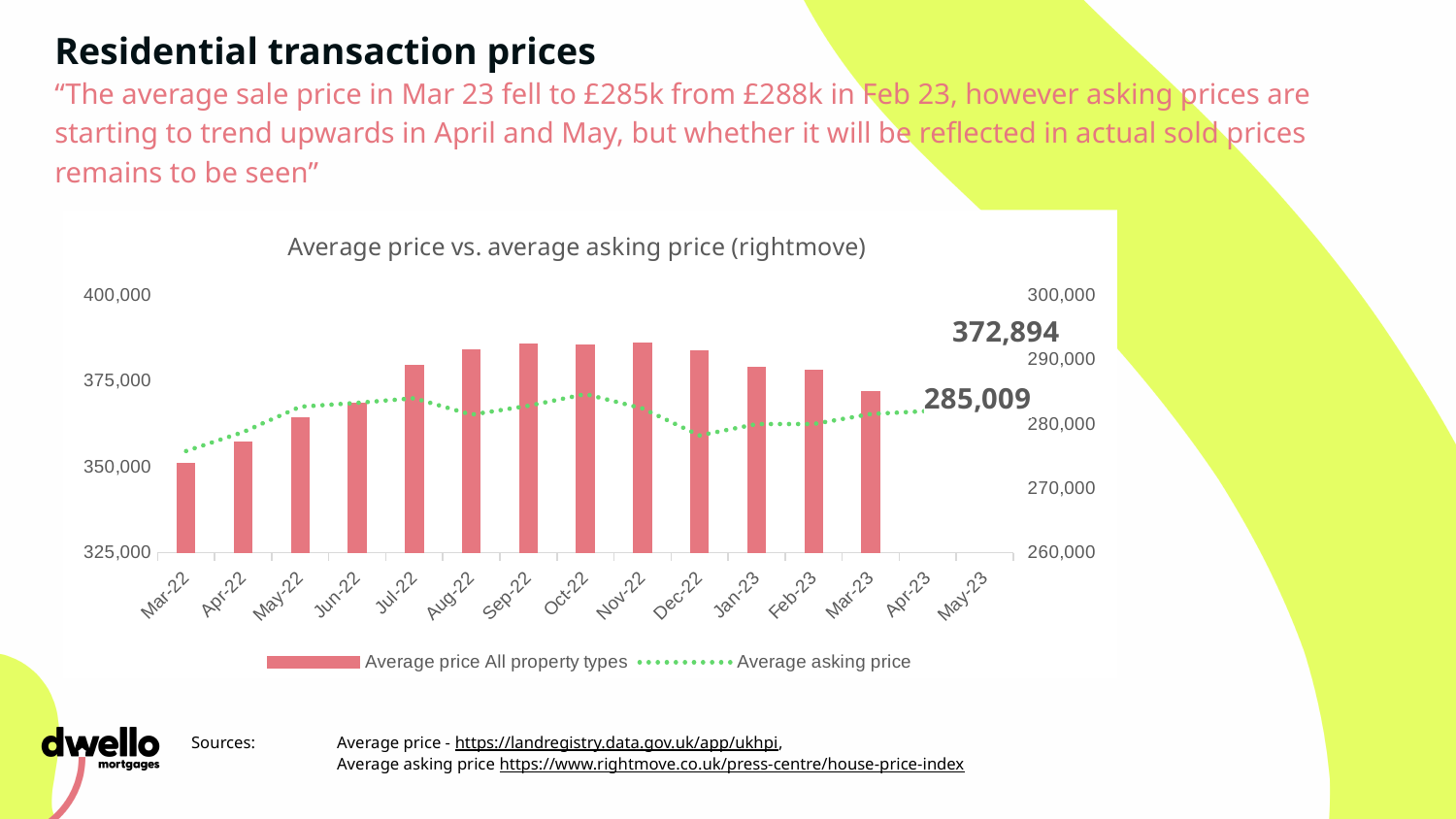
What value is labelled at the end of the Average asking price line? 372,894 How many months are labelled on the x axis of the chart? 15 Which month has the lowest bar for Average price All property types? Mar-22 Which bar is taller, Dec-22 or Jan-23? Dec-22 How many bars are plotted for Average price All property types? 13 Do the Average price bars rise or fall from Mar-22 to Nov-22? Rise What kind of chart is shown on the slide? A combined bar and line chart What is the title of the chart? Average price vs. average asking price (rightmove) Which series is drawn as a dotted line? Average asking price How many series does the chart legend list? 2 Which bar is taller, Mar-22 or Jul-22? Jul-22 What value is labelled next to the last bar (Mar-23) for Average price All property types? 285,009